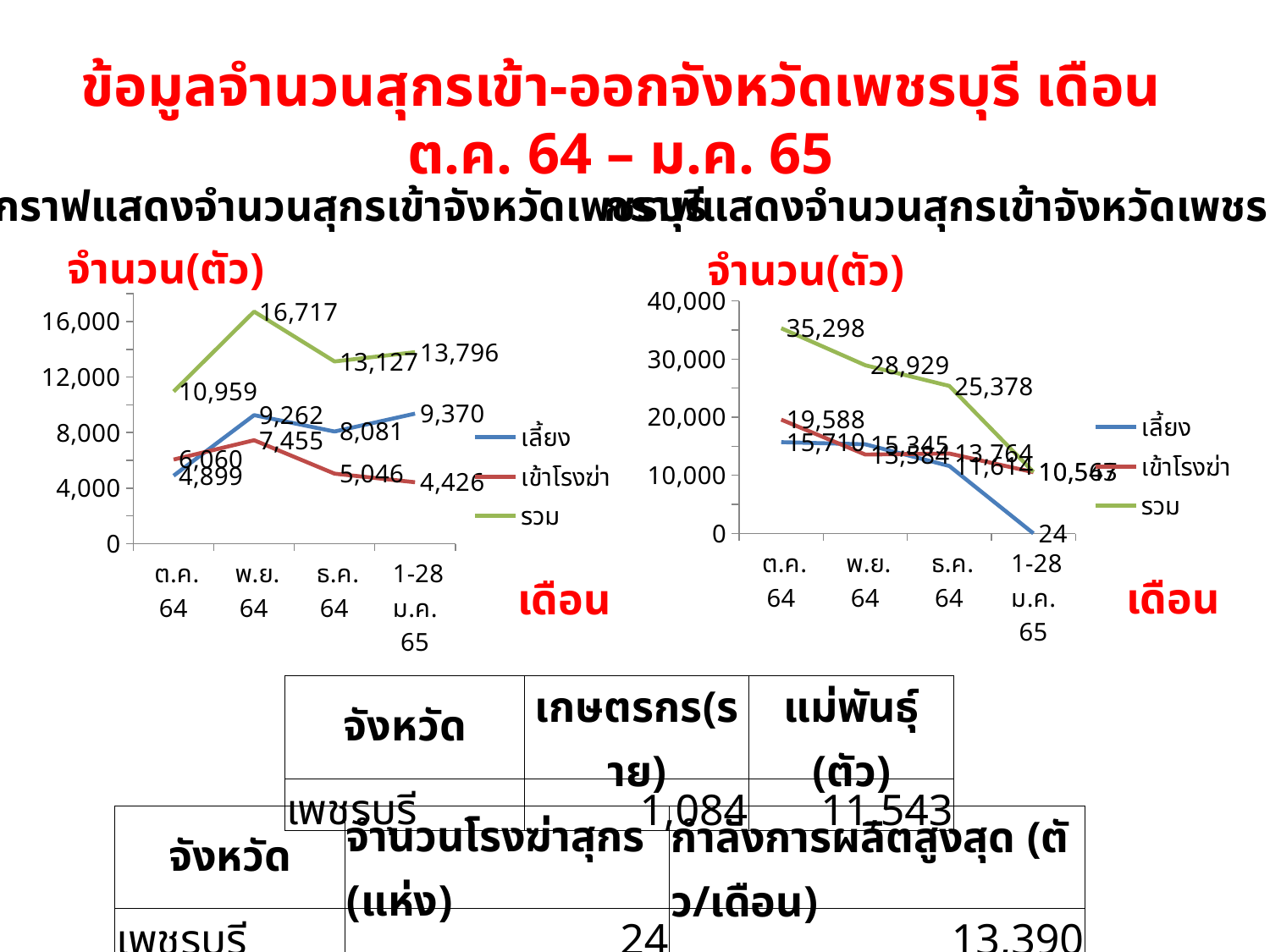
On the right chart, what is the value of the รวม series for ต.ค. 64? 35,298 On the right chart, what is the value of the เลี้ยง series for 1-28 ม.ค. 65? 24 On the left chart, what is the value of the รวม series for พ.ย. 64? 16,717 On the right chart, what is the value of the เข้าโรงฆ่า series for ธ.ค. 64? 13,764 On the right chart, does the รวม series rise or fall from ต.ค. 64 to 1-28 ม.ค. 65? fall How many series does the legend of the left chart list? 3 On the left chart, what is the value of the เข้าโรงฆ่า series for 1-28 ม.ค. 65? 4,426 On the right chart, which is larger for ต.ค. 64: เลี้ยง or เข้าโรงฆ่า? เข้าโรงฆ่า On the left chart, what is the value of the เลี้ยง series for ต.ค. 64? 4,899 On the left chart, what is the difference between the รวม values for พ.ย. 64 and ธ.ค. 64? 3,590 What type of chart is the right chart? line chart On the left chart, in which month is the รวม series highest? พ.ย. 64